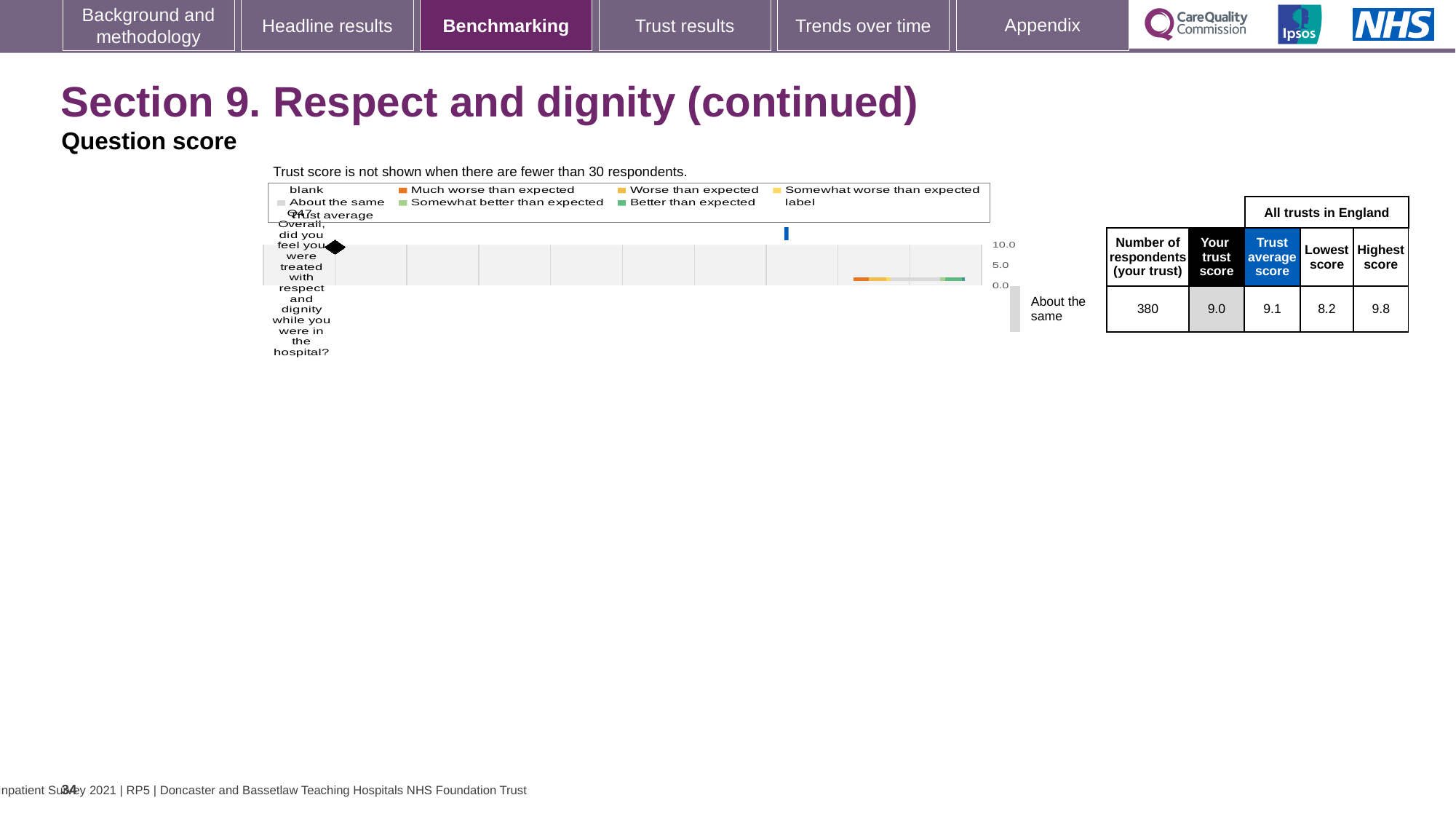
According to the table next to the chart, what is the highest score among all trusts in England for Q47? 9.8 According to the table next to the chart, what is the lowest score among all trusts in England for Q47? 8.2 For Q47, which is larger: the trust's own score or the trust average score? Trust average score According to the table next to the chart, what is the trust's score for Q47? 9.0 What is the difference between the highest score and the lowest score for Q47 in the table next to the chart? 1.6 Which question number is plotted on the chart? Q47 How many survey questions are plotted on the chart? 1 According to the table next to the chart, how many respondents did the trust have for Q47? 380 According to the table next to the chart, what is the trust average score for Q47? 9.1 What kind of chart is shown on the slide? bar chart What is the highest tick value shown on the chart's axis? 10.0 Is the trust's score for Q47 greater or less than 5.0 on the chart's axis? greater